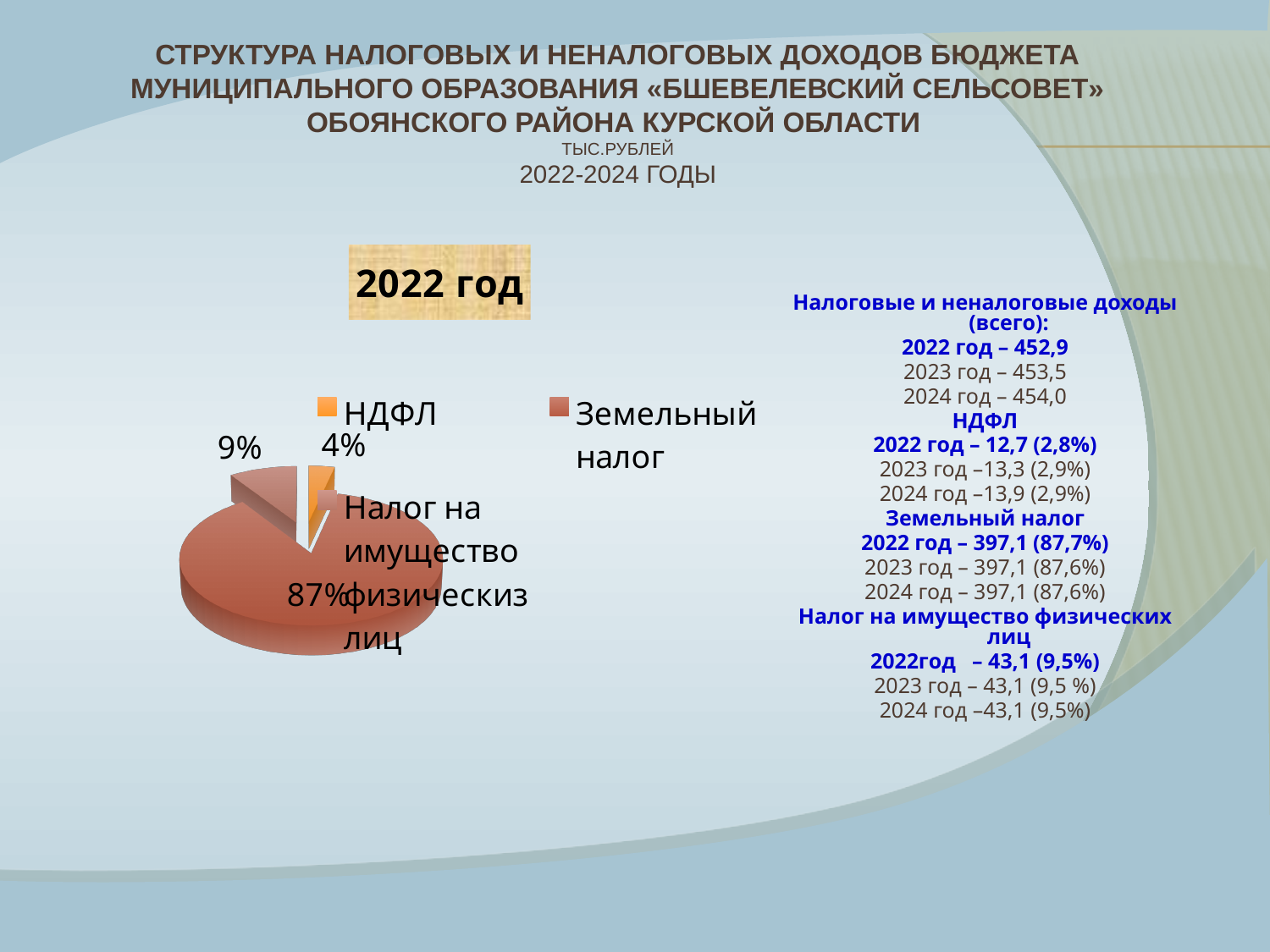
How many entries does the legend list? 3 Which category has the smallest slice of the pie? НДФЛ How many slices does the pie chart have? 3 Which slice is larger: Налог на имущество физических лиц or НДФЛ? Налог на имущество физических лиц What share of the pie does НДФЛ have? 4% What share of the pie does Налог на имущество физических лиц have? 9% Which year does the pie chart represent, according to the label above it? 2022 год What share of the pie does Земельный налог have? 87% What kind of chart is shown on the slide? pie chart By how many percentage points does the Земельный налог slice exceed the Налог на имущество физических лиц slice? 78 percentage points Which legend entry is shown in orange? НДФЛ Which category has the largest slice of the pie? Земельный налог